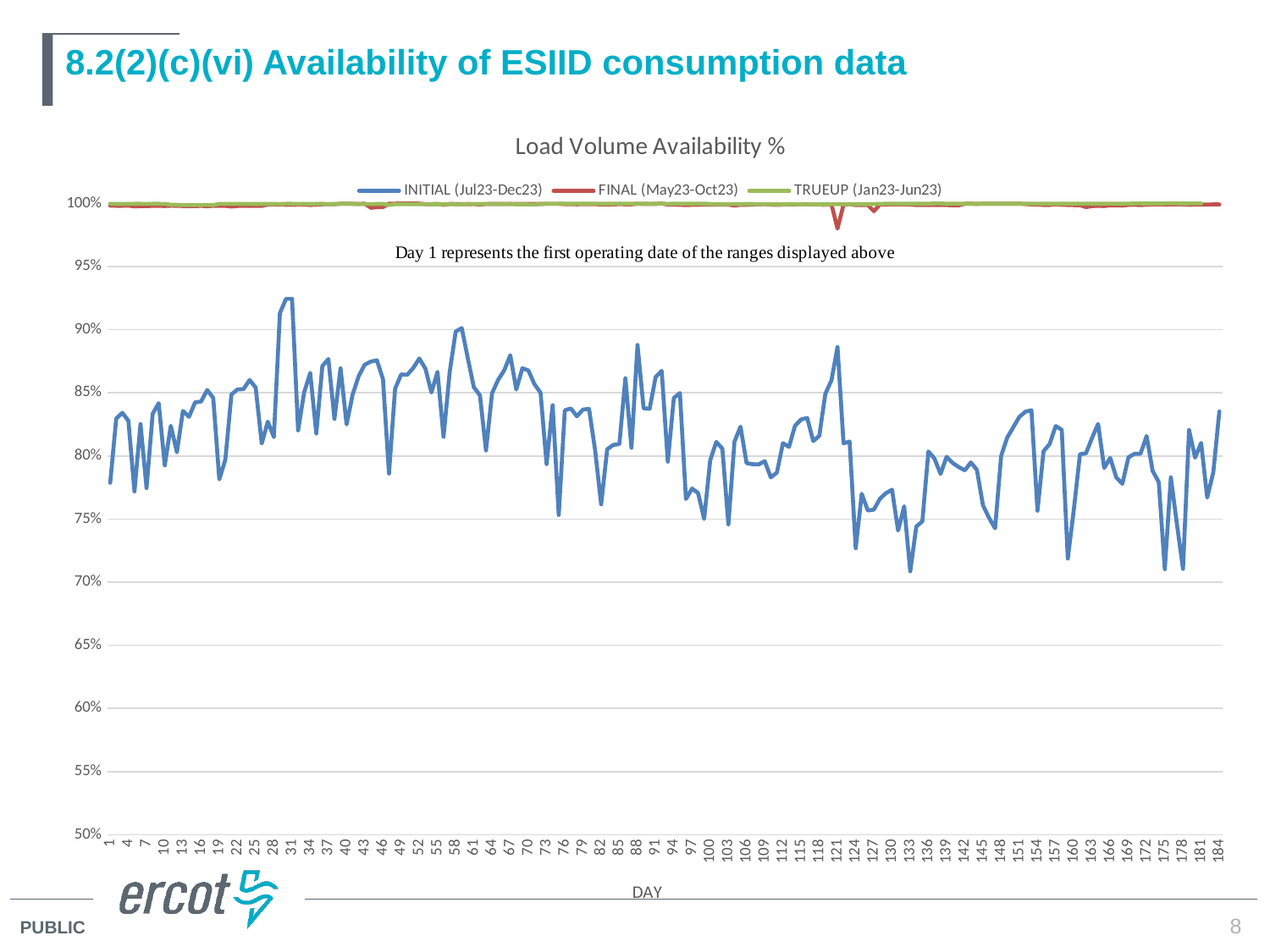
What is the label of the x axis? DAY Is the FINAL (May23-Oct23) value at day 100 greater or less than 95%? greater What is the last day number shown on the x axis? 184 Is the INITIAL (Jul23-Dec23) value at day 133 greater or less than 75%? less What type of chart is shown on the slide? line chart Is the INITIAL (Jul23-Dec23) value at day 121 greater or less than 85%? greater What is the title of the chart? Load Volume Availability % At day 100, which series has the larger value, INITIAL (Jul23-Dec23) or FINAL (May23-Oct23)? FINAL (May23-Oct23) Which series is plotted with the lowest values across the chart? INITIAL (Jul23-Dec23) How many series does the legend list? 3